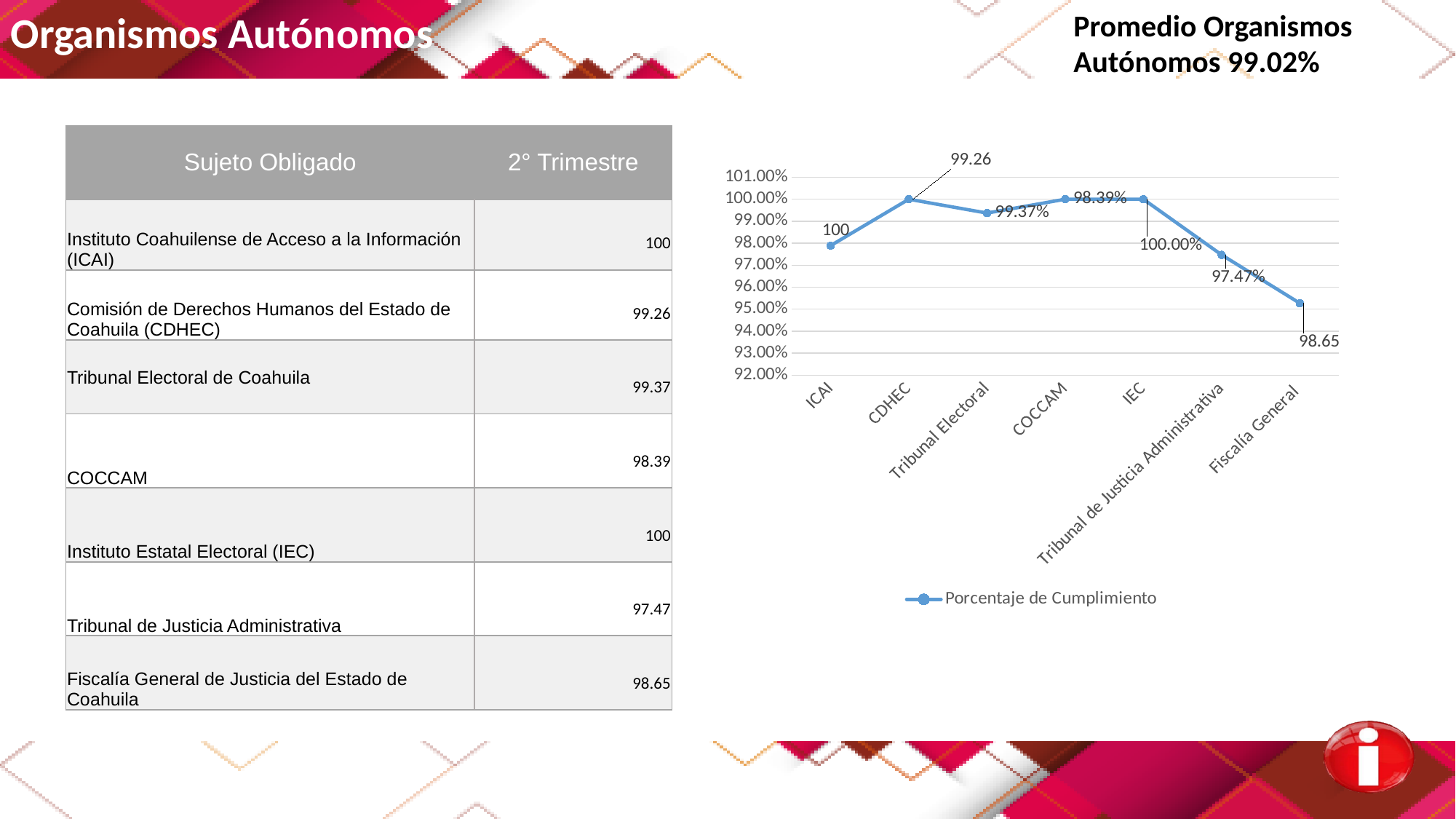
How many categories are plotted on the x axis of the chart? 7 What value is labelled for ICAI in the chart? 100 What value is labelled for Fiscalía General in the chart? 98.65 What kind of chart is shown on the slide? line chart How many series does the chart legend list? 1 What value is labelled for Tribunal de Justicia Administrativa in the chart? 97.47% What value is labelled for Tribunal Electoral in the chart? 99.37% What is the first category on the x axis of the chart? ICAI What value is labelled for COCCAM in the chart? 98.39% What value is labelled for CDHEC in the chart? 99.26 What is the name of the series shown in the chart legend? Porcentaje de Cumplimiento What value is labelled for IEC in the chart? 100.00%